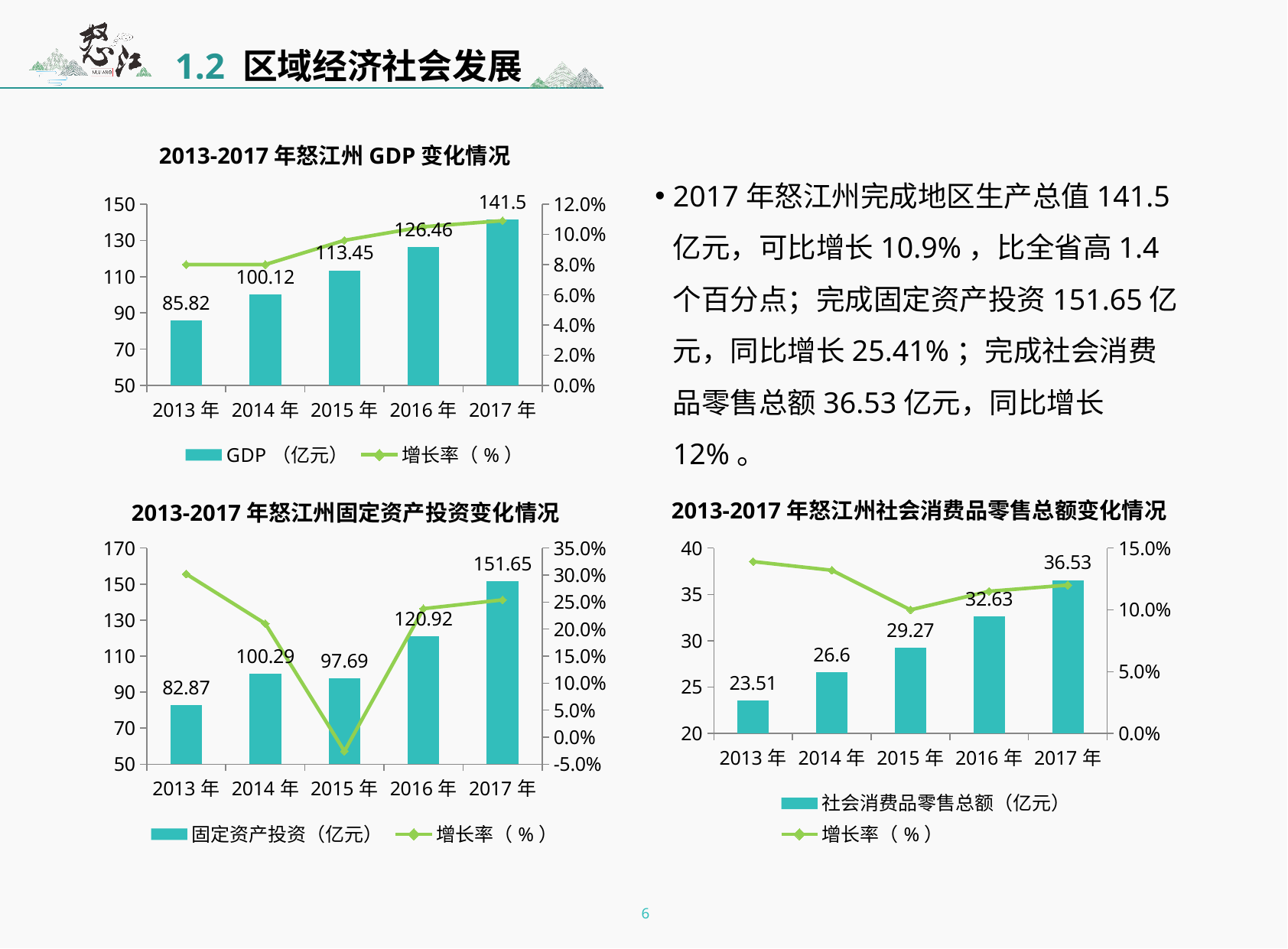
In the chart titled 2013-2017 年怒江州社会消费品零售总额变化情况, what is the value for 2014 年? 26.6 In the chart titled 2013-2017 年怒江州社会消费品零售总额变化情况, how many years are shown on the x axis? 5 In the chart titled 2013-2017 年怒江州固定资产投资变化情况, what is the fixed asset investment value for 2015 年? 97.69 In the chart titled 2013-2017 年怒江州固定资产投资变化情况, is the growth rate (增长率) for 2015 年 greater or less than 0.0%? less In the chart titled 2013-2017 年怒江州固定资产投资变化情况, which is larger, the fixed asset investment for 2014 年 or for 2015 年? 2014 年 In the chart titled 2013-2017 年怒江州 GDP 变化情况, what is the difference between the GDP values for 2017 年 and 2016 年? 15.04 In the chart titled 2013-2017 年怒江州 GDP 变化情况, which year has the lowest GDP? 2013 年 In the chart titled 2013-2017 年怒江州社会消费品零售总额变化情况, what is the difference between the values for 2017 年 and 2013 年? 13.02 In the chart titled 2013-2017 年怒江州固定资产投资变化情况, how many series does the legend list? 2 In the chart titled 2013-2017 年怒江州 GDP 变化情况, what is the GDP value for 2017 年? 141.5 In the chart titled 2013-2017 年怒江州 GDP 变化情况, do the GDP bars rise or fall from 2013 年 to 2017 年? rise In the chart titled 2013-2017 年怒江州固定资产投资变化情况, which year has the highest fixed asset investment? 2017 年